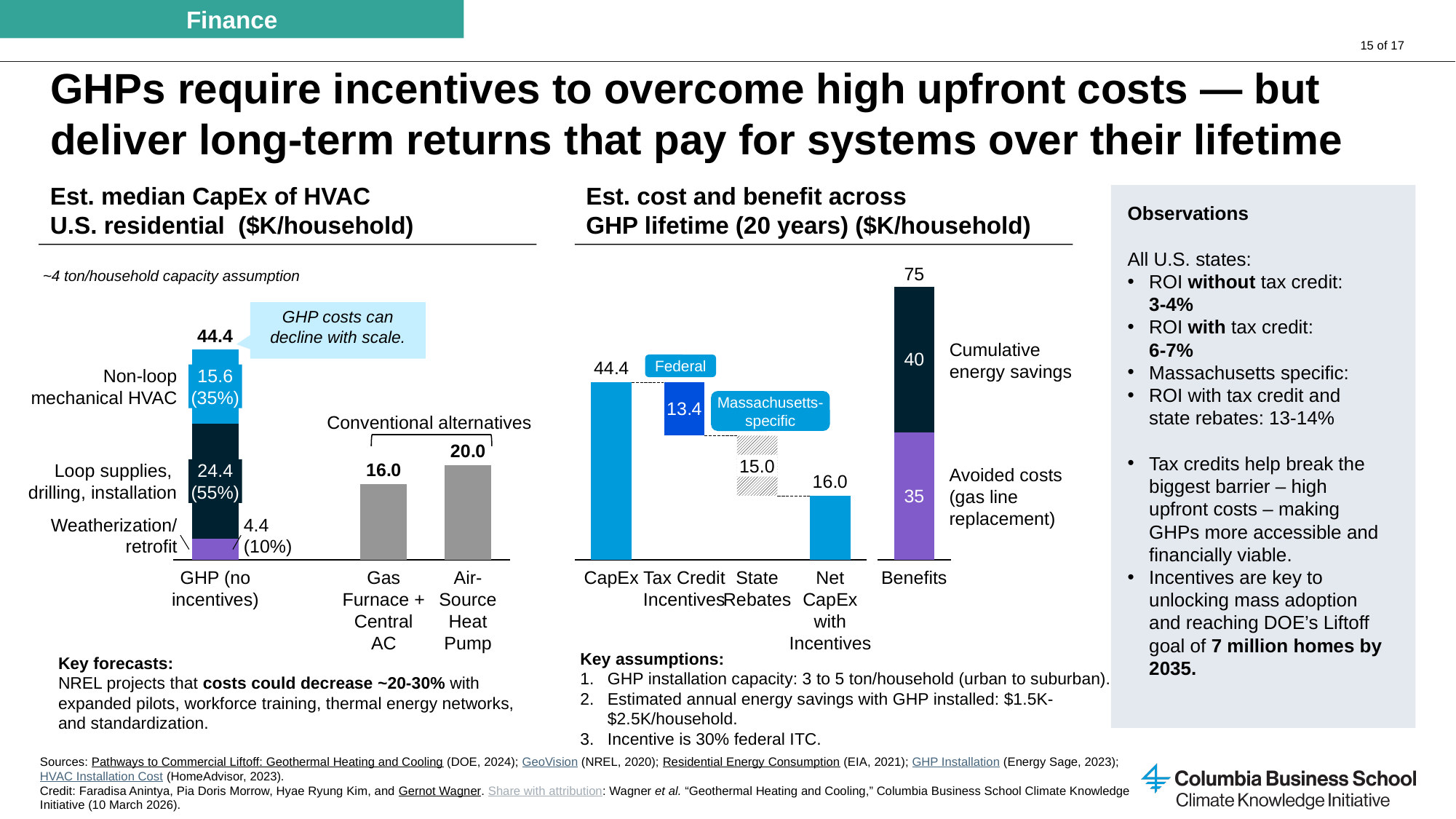
In the left chart (Est. median CapEx of HVAC U.S. residential), what is the CapEx for the Air-Source Heat Pump? 20.0 In the right chart (Est. cost and benefit across GHP lifetime), what is the Net CapEx with Incentives? 16.0 In the right chart (Est. cost and benefit across GHP lifetime), what is the difference between the Benefits total and the Net CapEx with Incentives? 59 In the right chart (Est. cost and benefit across GHP lifetime), which is larger: Cumulative energy savings or Avoided costs? Cumulative energy savings In the left chart (Est. median CapEx of HVAC U.S. residential), what share of the GHP CapEx is Weatherization/retrofit? 10% In the right chart (Est. cost and benefit across GHP lifetime), what is the total of the Benefits bar? 75 In the left chart (Est. median CapEx of HVAC U.S. residential), which system has the lowest CapEx? Gas Furnace + Central AC In the left chart (Est. median CapEx of HVAC U.S. residential), what is the value for Loop supplies, drilling, installation in the GHP bar? 24.4 In the left chart (Est. median CapEx of HVAC U.S. residential), what is the total CapEx for GHP (no incentives)? 44.4 In the right chart (Est. cost and benefit across GHP lifetime), what is the value of the Tax Credit Incentives? 13.4 In the left chart (Est. median CapEx of HVAC U.S. residential), how many systems are compared? 3 In the left chart (Est. median CapEx of HVAC U.S. residential), how much higher is the GHP (no incentives) CapEx than the Gas Furnace + Central AC CapEx? 28.4